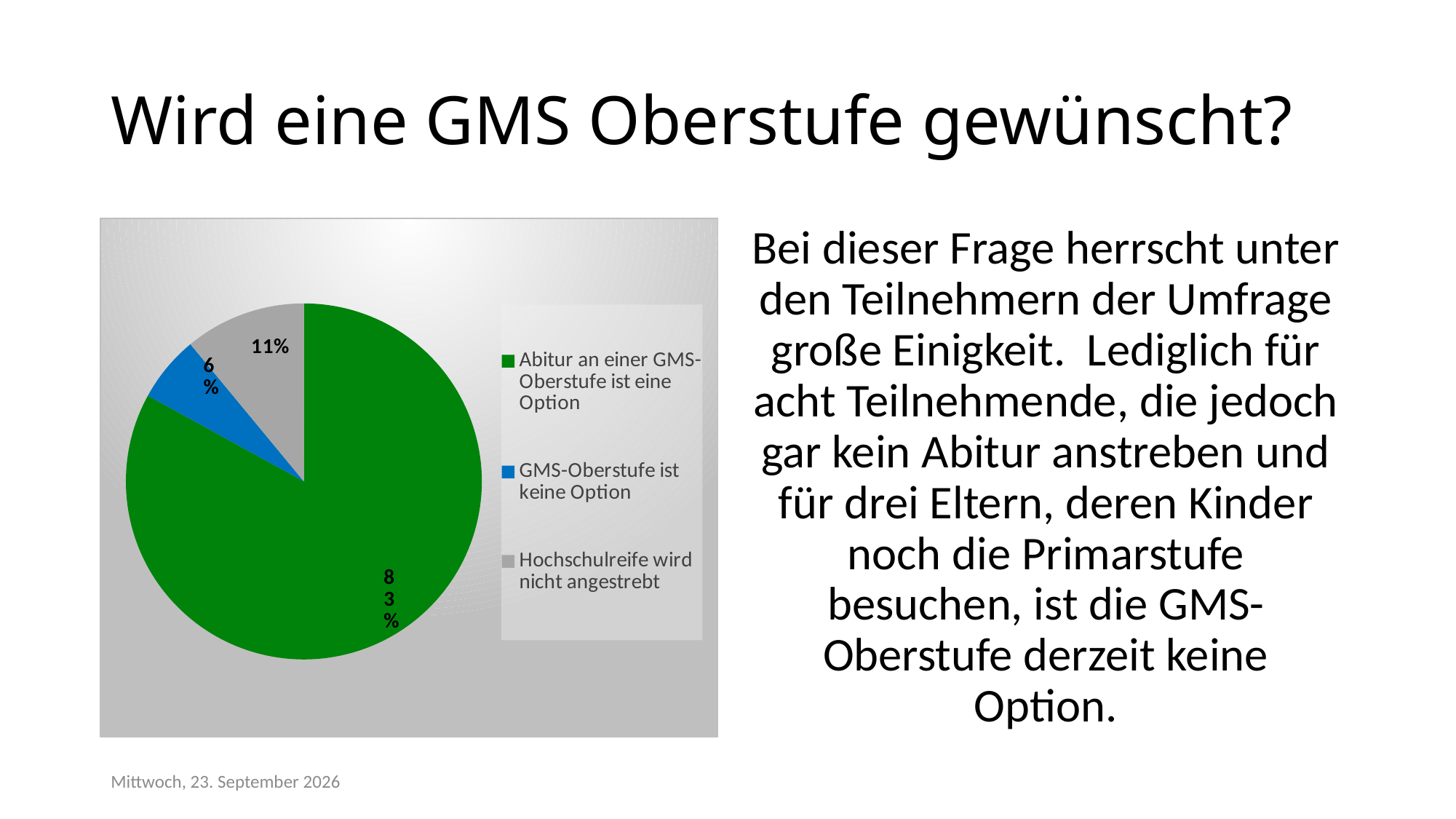
What share of the pie does "GMS-Oberstufe ist keine Option" have? 6% What kind of chart is shown on the slide? pie chart What share of the pie does "Abitur an einer GMS-Oberstufe ist eine Option" have? 83% What is the difference in percentage points between "Abitur an einer GMS-Oberstufe ist eine Option" and "Hochschulreife wird nicht angestrebt"? 72 What share of the pie does "Hochschulreife wird nicht angestrebt" have? 11% What colour is the slice for "GMS-Oberstufe ist keine Option"? blue What colour is the slice for "Hochschulreife wird nicht angestrebt"? grey How many entries does the legend list? 3 How many slices does the pie chart have? 3 Which category has the largest slice of the pie? Abitur an einer GMS-Oberstufe ist eine Option Which category has the smallest slice of the pie? GMS-Oberstufe ist keine Option Which is larger: the slice for "Hochschulreife wird nicht angestrebt" or the slice for "GMS-Oberstufe ist keine Option"? Hochschulreife wird nicht angestrebt